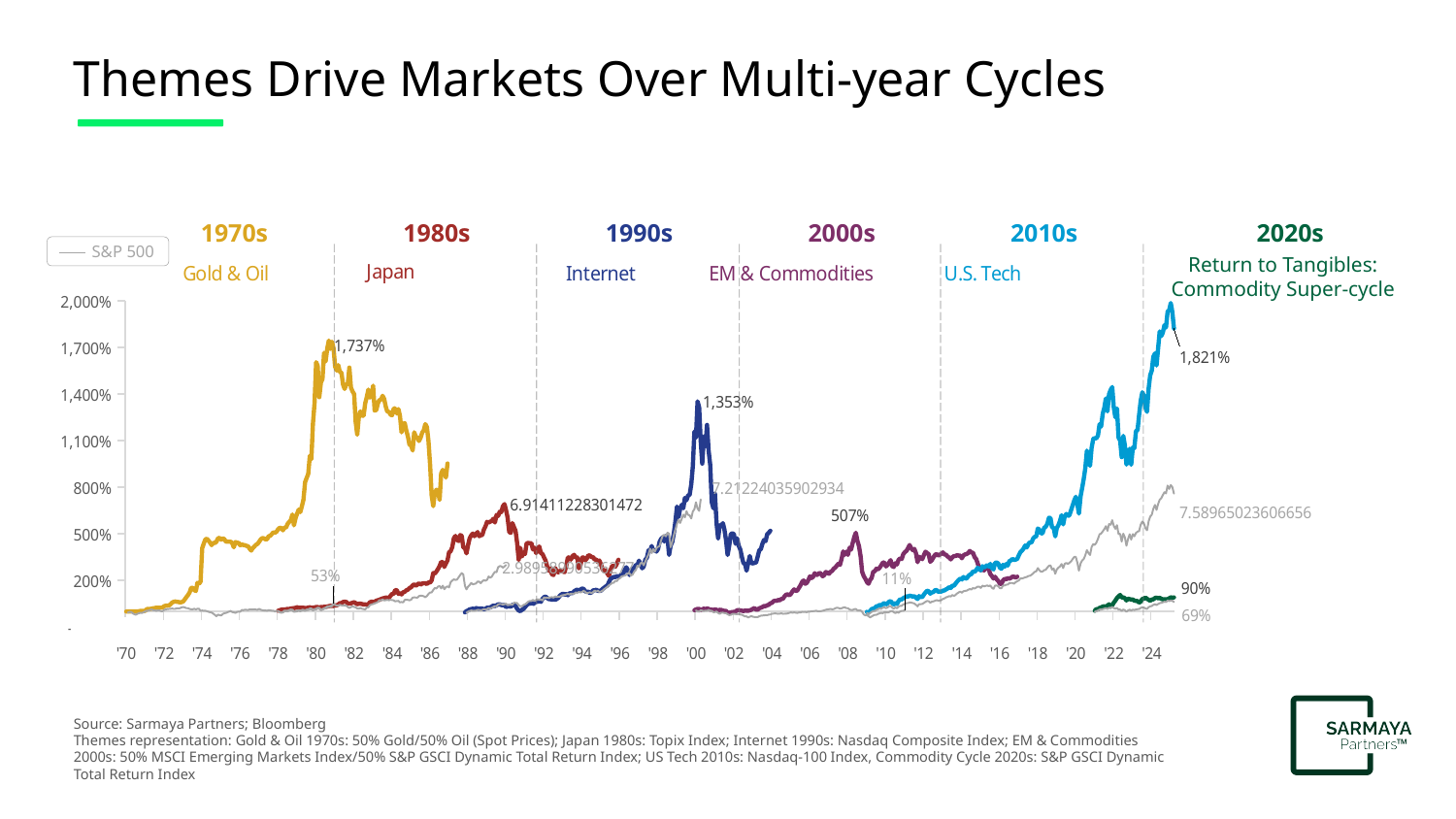
What peak value is labeled for the EM & Commodities theme of the 2000s? 507% What peak value is labeled for the Gold & Oil theme of the 1970s? 1,737% What is the difference between the labeled peaks of U.S. Tech (1,821%) and Gold & Oil (1,737%)? 84 percentage points What peak value is labeled for the Internet theme of the 1990s? 1,353% What type of chart is shown on the slide? Line chart Which series is listed in the chart's legend box? S&P 500 How many decade themes are marked across the top of the chart? 6 Which labeled peak is larger: Gold & Oil (1970s) or Internet (1990s)? Gold & Oil (1970s) Which decade theme has the highest labeled peak value? U.S. Tech (2010s) Is the peak of the Japan (1980s) line greater or less than 800%? less What peak value is labeled for the U.S. Tech theme of the 2010s? 1,821% What value is labeled for the Return to Tangibles: Commodity Super-cycle line in the 2020s? 90%